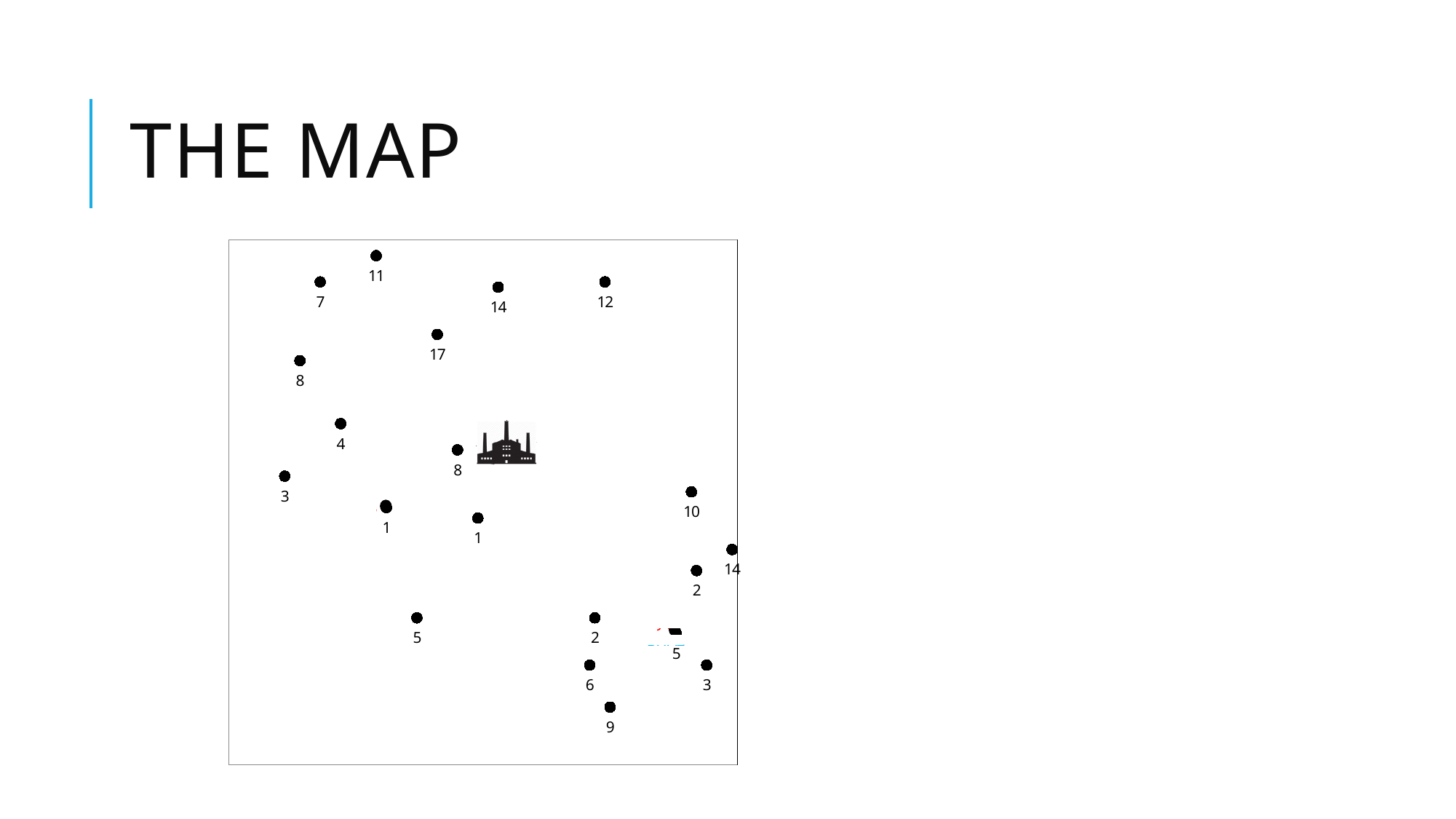
What icon is placed near the centre of the chart next to the point labelled 8? a factory How many points on the chart are labelled 8? 2 What is the highest number labelled on any point in the chart? 17 How many points on the chart are labelled 1? 2 What kind of chart is shown on the slide? scatter chart What is the label of the point nearest the right edge of the chart? 14 How many points on the chart are labelled 14? 2 What is the lowest number labelled on any point in the chart? 1 What is the title of the slide containing the chart? THE MAP What is the label of the point nearest the bottom edge of the chart? 9 What is the label of the point nearest the top edge of the chart? 11